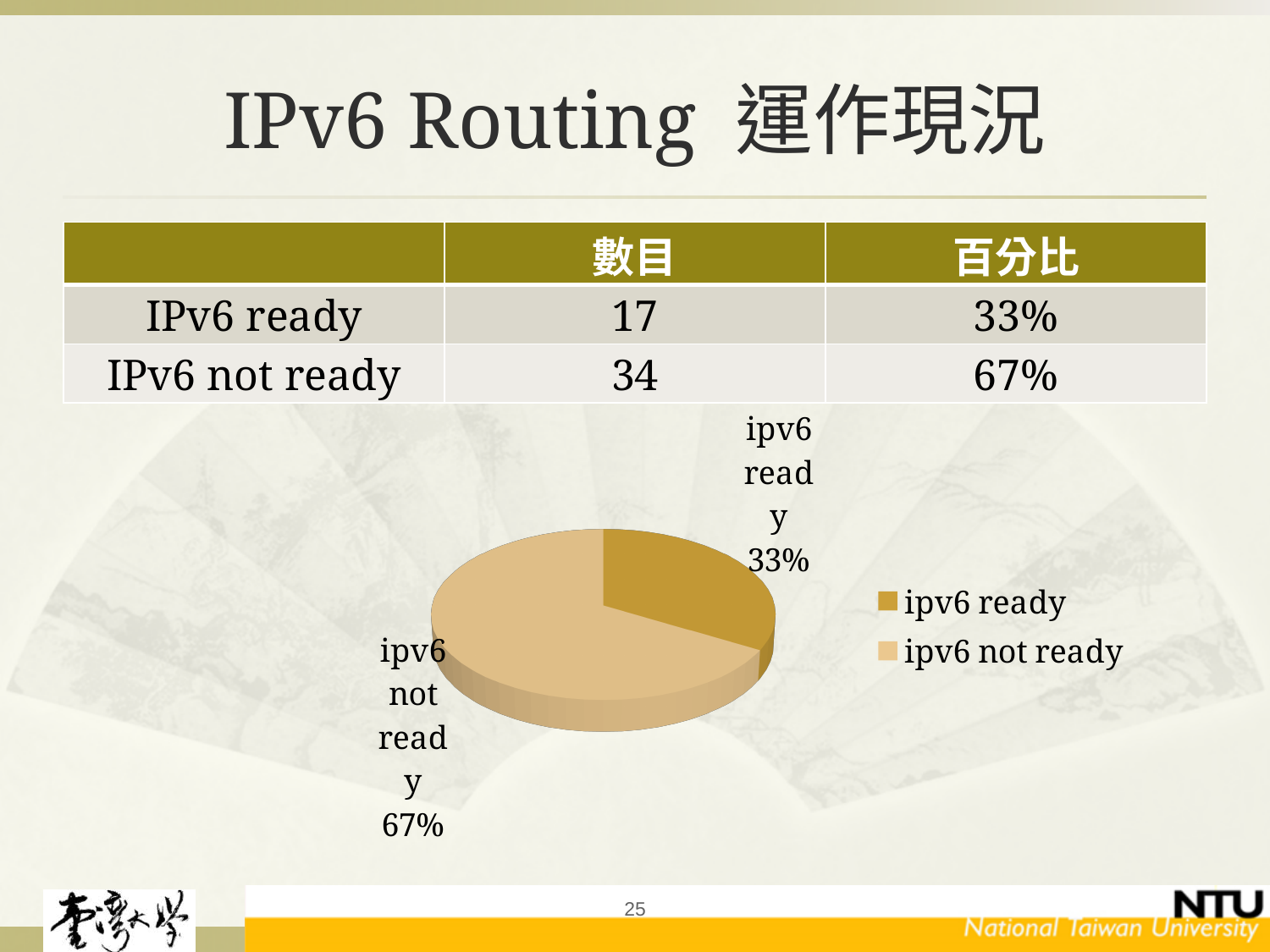
What share of the pie does the ipv6 not ready slice represent? 67% What kind of chart is shown on the slide? pie chart What is the difference in percentage points between the ipv6 not ready slice and the ipv6 ready slice? 34% Which slice of the pie is the smallest? ipv6 ready Which legend entry is shown in the darker gold colour? ipv6 ready Which slice of the pie is the largest? ipv6 not ready How many slices does the pie chart have? 2 Where is the legend positioned relative to the pie? to the right How many entries does the legend list? 2 Is the share for ipv6 ready greater or less than 50%? less What share of the pie does the ipv6 ready slice represent? 33% Which is larger, the ipv6 ready slice or the ipv6 not ready slice? ipv6 not ready